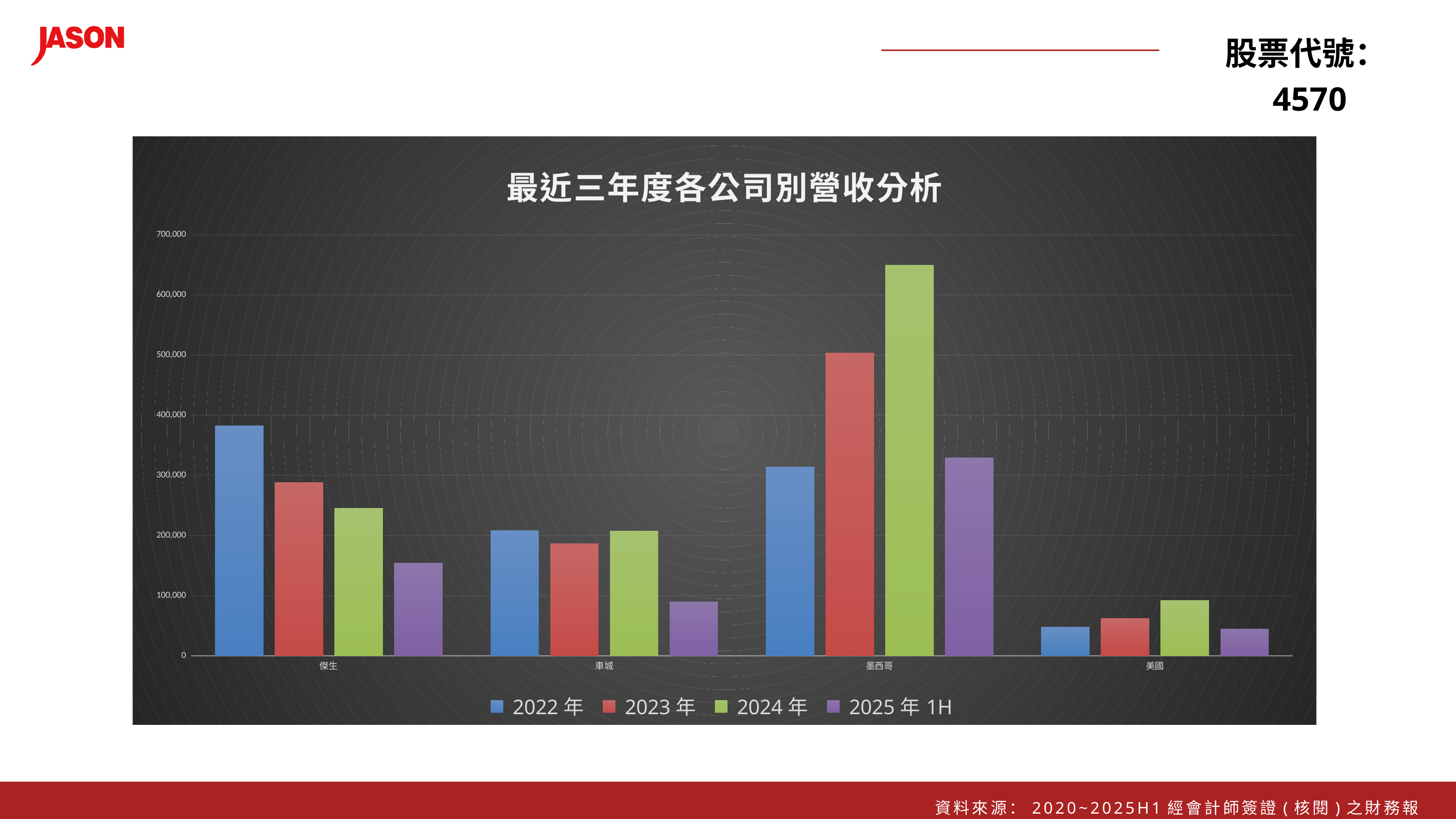
Is the 2022 年 value for 美國 greater or less than 100,000? less For 傑生, do the values rise or fall from 2022 年 through 2025 年 1H? fall How many companies (categories) are shown on the x axis? 4 What kind of chart is shown on the slide? bar chart Is the 2022 年 value for 傑生 greater or less than 300,000? greater Which category has the highest value for the 2024 年 series? 墨西哥 For the 2022 年 series, which is larger: 傑生 or 墨西哥? 傑生 How many series does the legend list? 4 What is the title of the chart? 最近三年度各公司別營收分析 Is the 2025 年 1H value for 墨西哥 greater or less than 300,000? greater Which category has the lowest value for the 2022 年 series? 美國